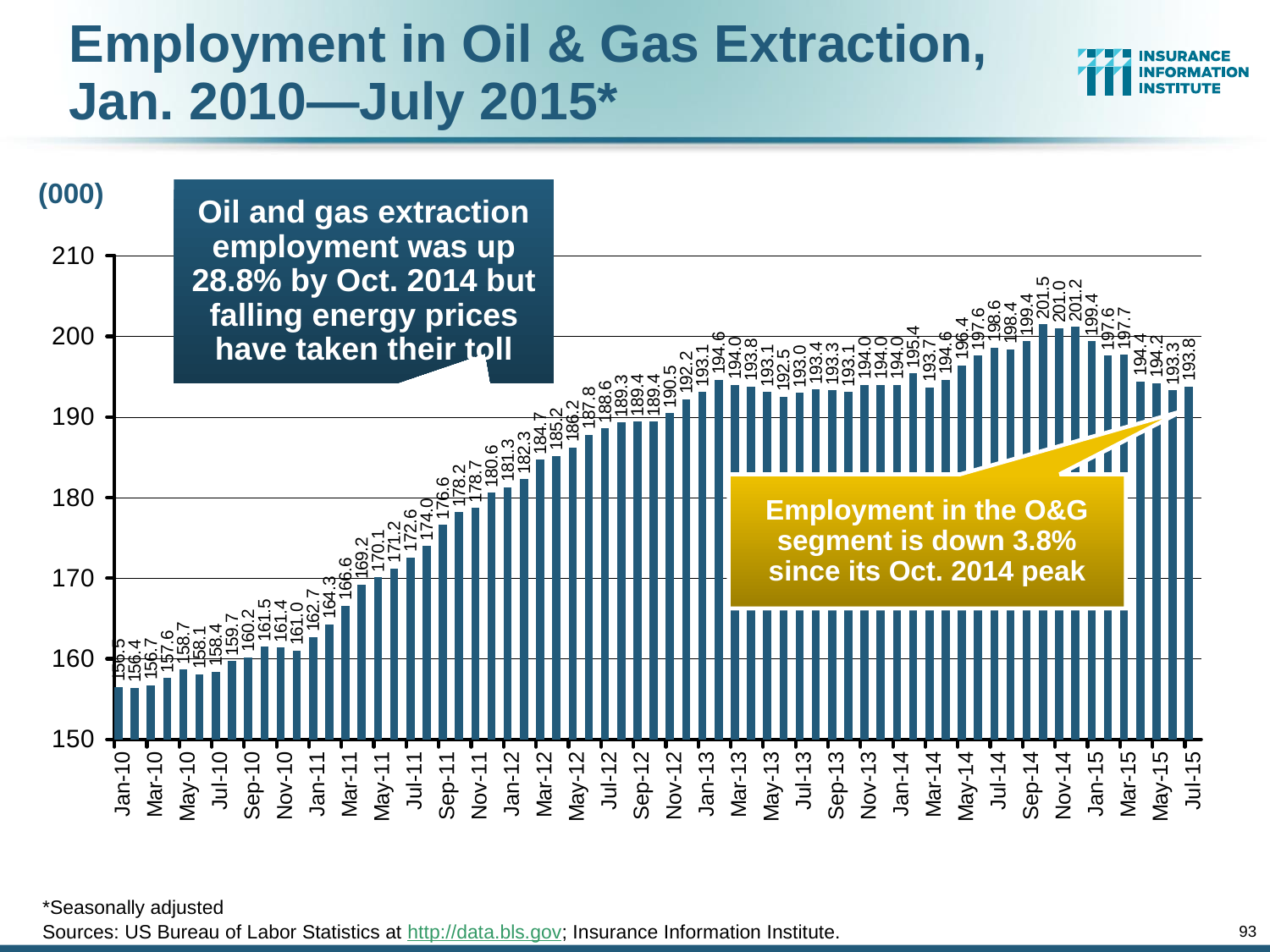
What is the employment value for Jul-15, the last bar in the chart? 193.8 Do the values generally rise or fall from Jan-10 to Oct-14? rise What is the difference between the Jul-15 value (193.8) and the Jan-10 value (156.5)? 37.3 Is the value for Jan-10 greater or less than 160? less Which is larger, the value for Jan-10 or the value for Jul-15? Jul-15 What is the employment value for Jan-10, the first bar in the chart? 156.5 What is the highest value shown in the chart? 201.5 Is the value for Jul-15 greater or less than 190? greater How many monthly bars are plotted in the chart (Jan 2010 through July 2015)? 67 What is the difference between the peak value of 201.5 and the Jul-15 value of 193.8? 7.7 What type of chart is shown on the slide? bar chart In what units are the values on the chart expressed, according to the label above the y-axis? (000)